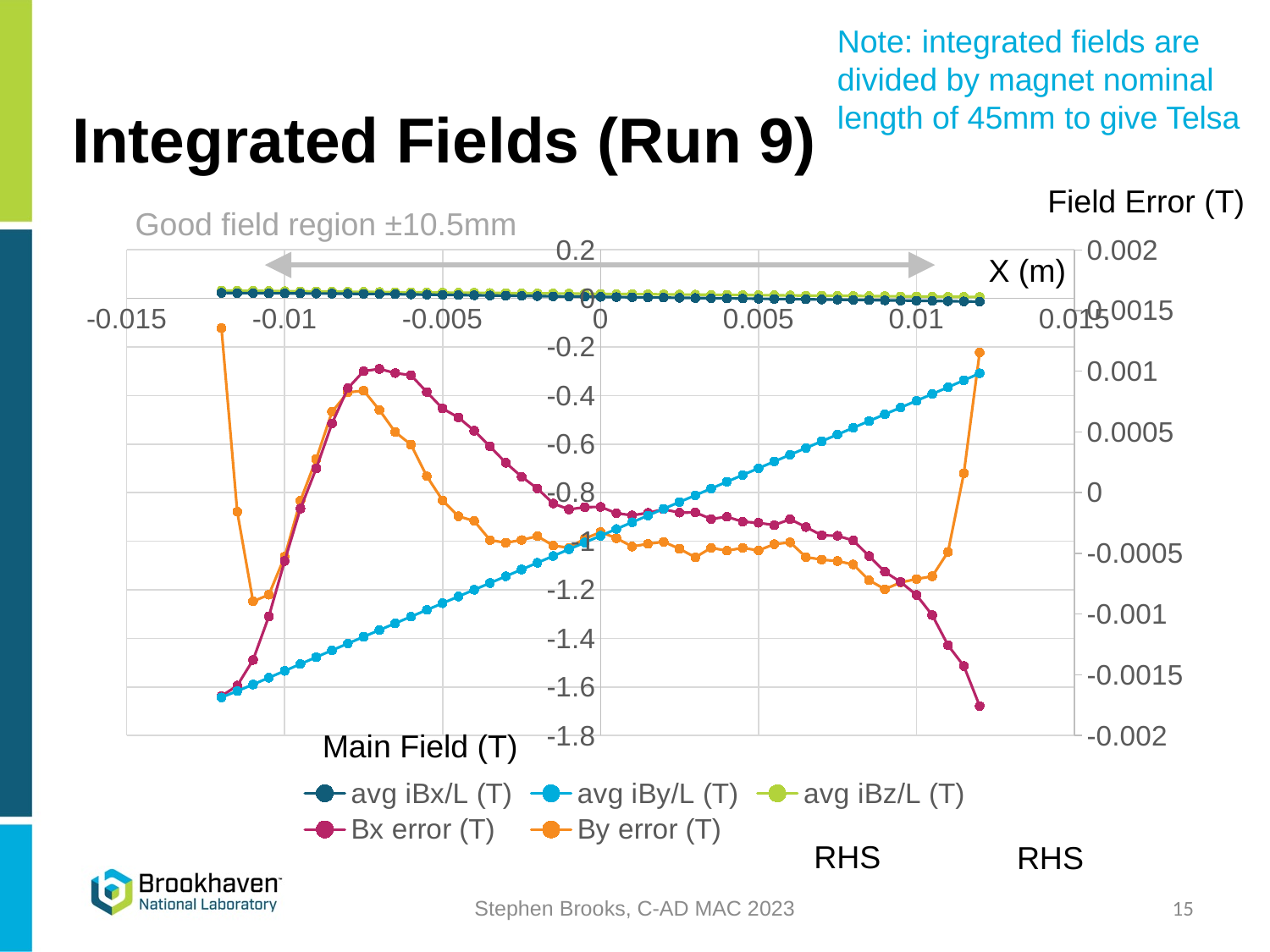
Does the avg iBy/L (T) series rise or fall as X increases from -0.012 to 0.012? rise Is the value of avg iBx/L (T) at X = 0 greater or less than -0.2 on the Main Field axis? greater Is the peak value of Bx error (T) near X = -0.007 greater or less than 0.0005 on the Field Error axis? greater At X = -0.012, which series has the larger value: Bx error (T) or By error (T)? By error (T) How many series does the chart legend list? 5 What good field region is labelled above the chart? ±10.5mm What kind of chart is shown on the slide? line chart At X = 0.012, which series has the larger value: Bx error (T) or By error (T)? By error (T) Is the value of avg iBy/L (T) at X = 0.012 greater or less than -0.6 on the Main Field axis? greater What is the title of the right-hand vertical axis? Field Error (T) Does the Bx error (T) series rise or fall as X increases from 0 to 0.012? fall